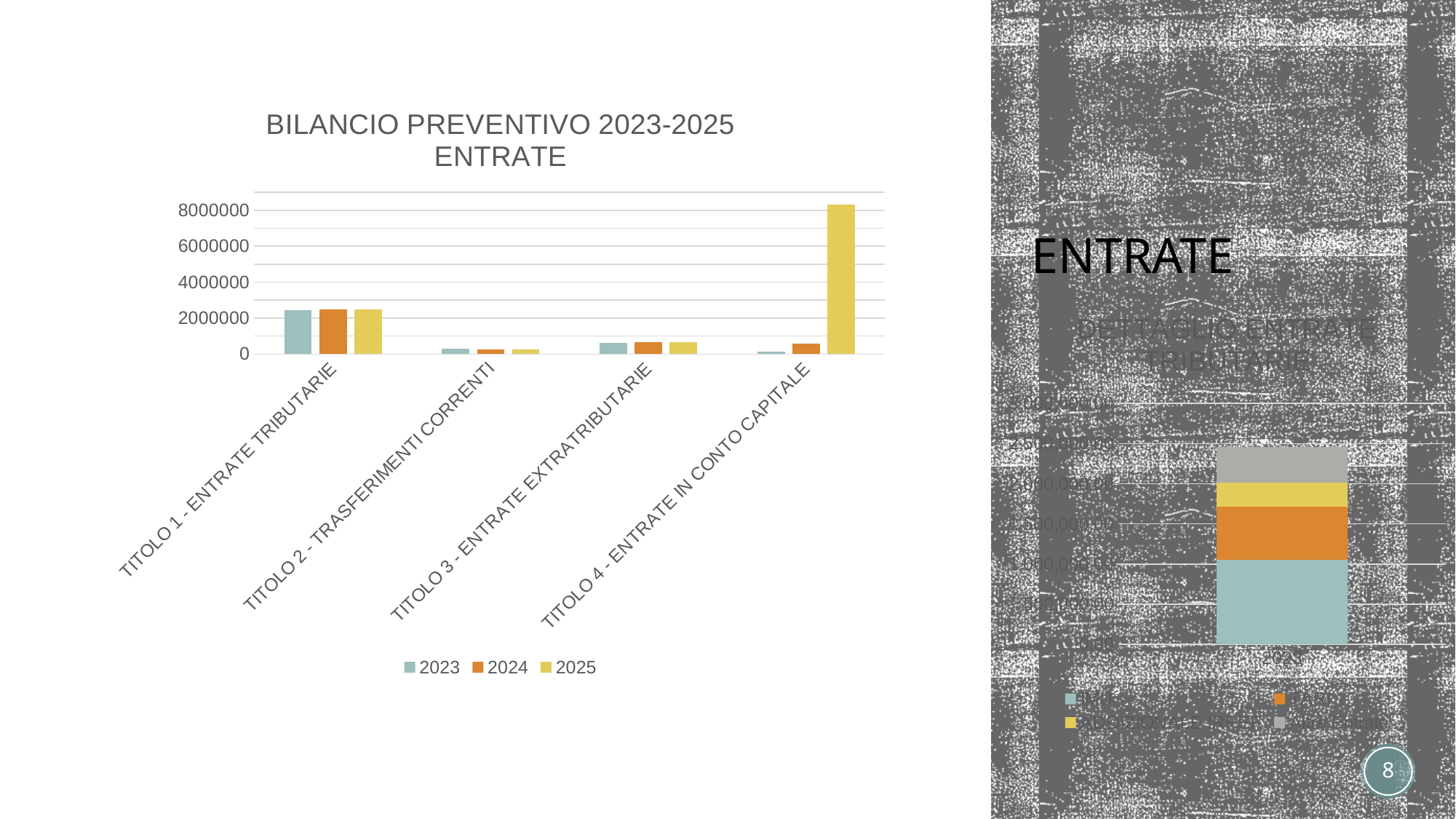
On the chart titled 'BILANCIO PREVENTIVO 2023-2025 ENTRATE', is the 2025 value for TITOLO 4 - ENTRATE IN CONTO CAPITALE greater or less than 8000000? greater On the chart titled 'BILANCIO PREVENTIVO 2023-2025 ENTRATE', how many categories are shown on the x axis? 4 On the chart titled 'BILANCIO PREVENTIVO 2023-2025 ENTRATE', is the 2024 value for TITOLO 2 - TRASFERIMENTI CORRENTI greater or less than 2000000? less On the chart titled 'BILANCIO PREVENTIVO 2023-2025 ENTRATE', how many series does the legend list? 3 On the chart titled 'BILANCIO PREVENTIVO 2023-2025 ENTRATE', which is larger for 2023: TITOLO 1 - ENTRATE TRIBUTARIE or TITOLO 3 - ENTRATE EXTRATRIBUTARIE? TITOLO 1 - ENTRATE TRIBUTARIE On the chart titled 'BILANCIO PREVENTIVO 2023-2025 ENTRATE', do the values for TITOLO 4 - ENTRATE IN CONTO CAPITALE rise or fall from 2023 to 2025? Rise On the chart titled 'BILANCIO PREVENTIVO 2023-2025 ENTRATE', is the 2023 value for TITOLO 1 - ENTRATE TRIBUTARIE greater or less than 2000000? greater On the chart titled 'BILANCIO PREVENTIVO 2023-2025 ENTRATE', which series is shown in orange? 2024 On the chart titled 'BILANCIO PREVENTIVO 2023-2025 ENTRATE', what kind of chart is shown? Bar chart On the chart titled 'BILANCIO PREVENTIVO 2023-2025 ENTRATE', which category has the tallest bar for the 2023 series? TITOLO 1 - ENTRATE TRIBUTARIE On the chart titled 'BILANCIO PREVENTIVO 2023-2025 ENTRATE', which category has the tallest bar for the 2025 series? TITOLO 4 - ENTRATE IN CONTO CAPITALE On the chart titled 'BILANCIO PREVENTIVO 2023-2025 ENTRATE', which is larger for 2025: TITOLO 1 - ENTRATE TRIBUTARIE or TITOLO 4 - ENTRATE IN CONTO CAPITALE? TITOLO 4 - ENTRATE IN CONTO CAPITALE